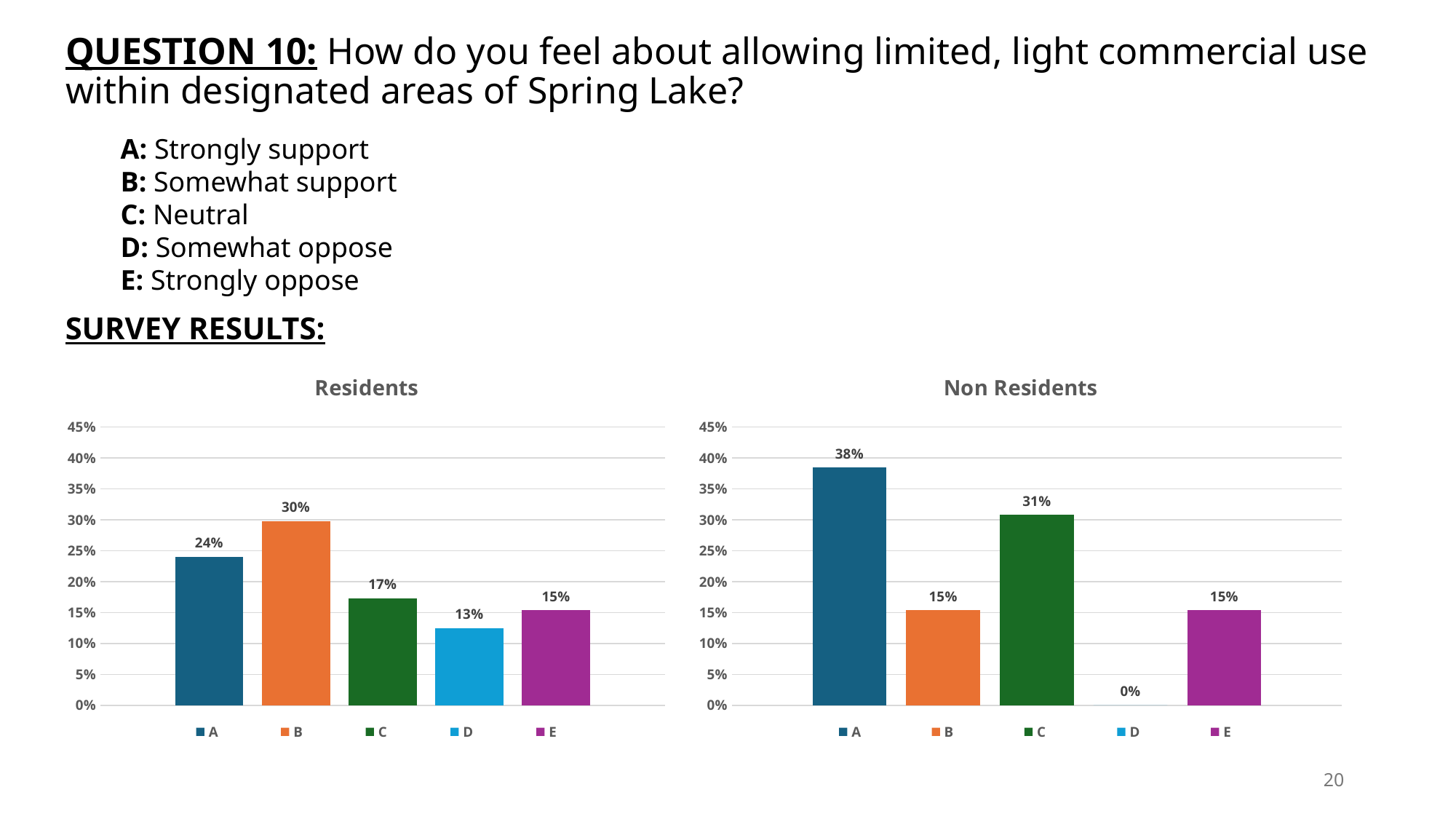
What is the title of the chart on the right side of the slide? Non Residents In the Residents chart, what is the value for B? 30% In the Non Residents chart, is the value for C greater or less than 25%? greater How many categories are shown in the Residents chart? 5 In the Non Residents chart, what is the difference between the values for A and C? 7% In the Residents chart, what is the difference between the values for B and D? 17% In the Residents chart, what is the value for D? 13% In the Non Residents chart, which category has the lowest value? D In the Non Residents chart, what is the value for A? 38% In the Residents chart, which is larger, the value for A or the value for C? A What kind of chart is the Non Residents chart? bar chart In the Residents chart, which category has the highest value? B